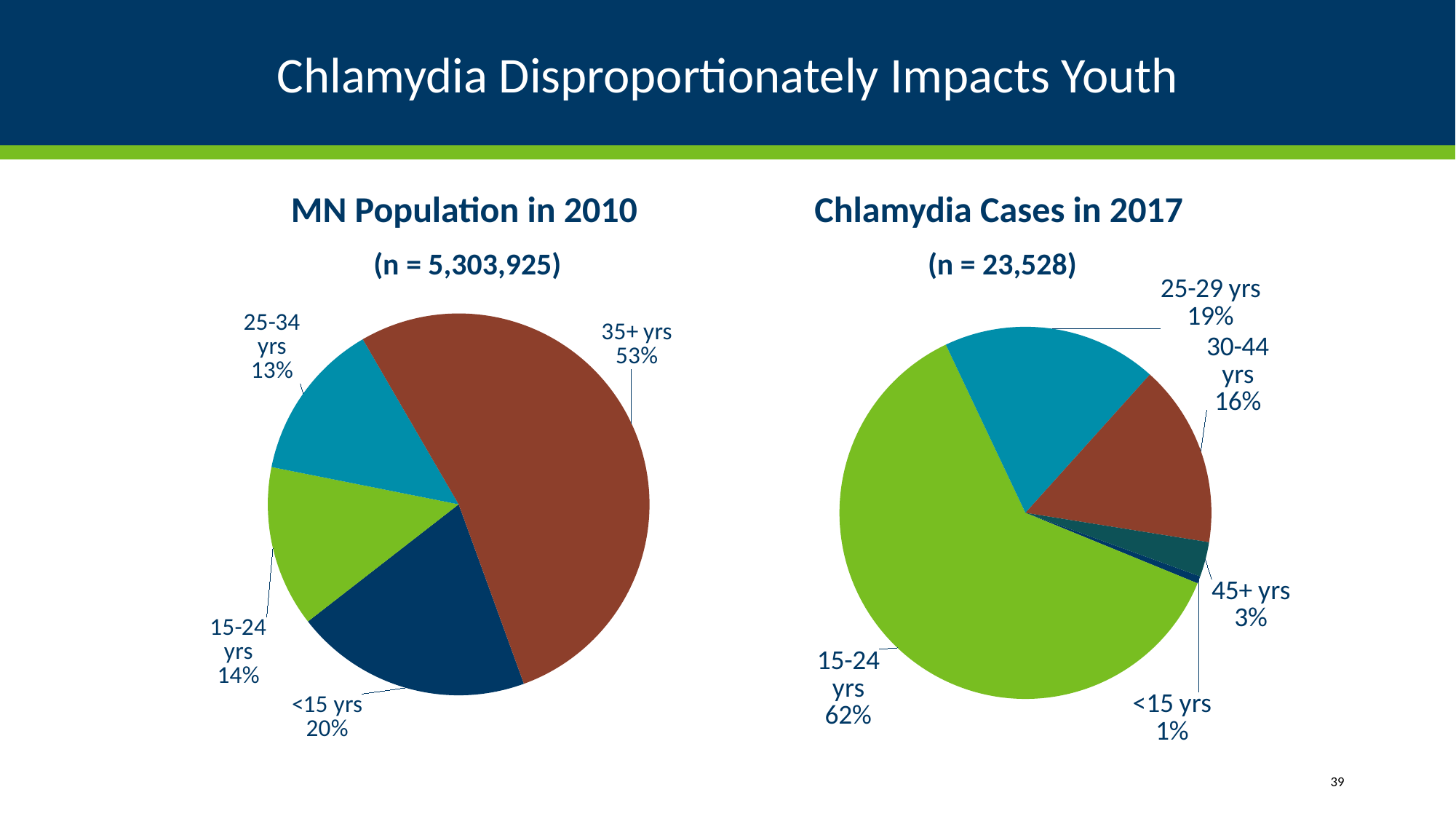
What kind of chart is used for 'MN Population in 2010'? Pie chart In the 'MN Population in 2010' chart, which is larger: the <15 yrs share or the 15-24 yrs share? <15 yrs In the 'MN Population in 2010' chart, which age group has the largest share? 35+ yrs In the 'MN Population in 2010' chart, what share of the population is 35+ yrs? 53% In the 'Chlamydia Cases in 2017' chart, what share of cases is 30-44 yrs? 16% In the 'Chlamydia Cases in 2017' chart, which age group has the smallest share? <15 yrs In the 'Chlamydia Cases in 2017' chart, what share of cases is 15-24 yrs? 62% In the 'Chlamydia Cases in 2017' chart, what is the difference between the 25-29 yrs share and the 45+ yrs share? 16% In the 'MN Population in 2010' chart, what share of the population is 15-24 yrs? 14% How many slices does the 'Chlamydia Cases in 2017' chart have? 5 What is the sample size (n) shown for the 'Chlamydia Cases in 2017' chart? 23,528 In the 'MN Population in 2010' chart, which age group has the smallest share? 25-34 yrs